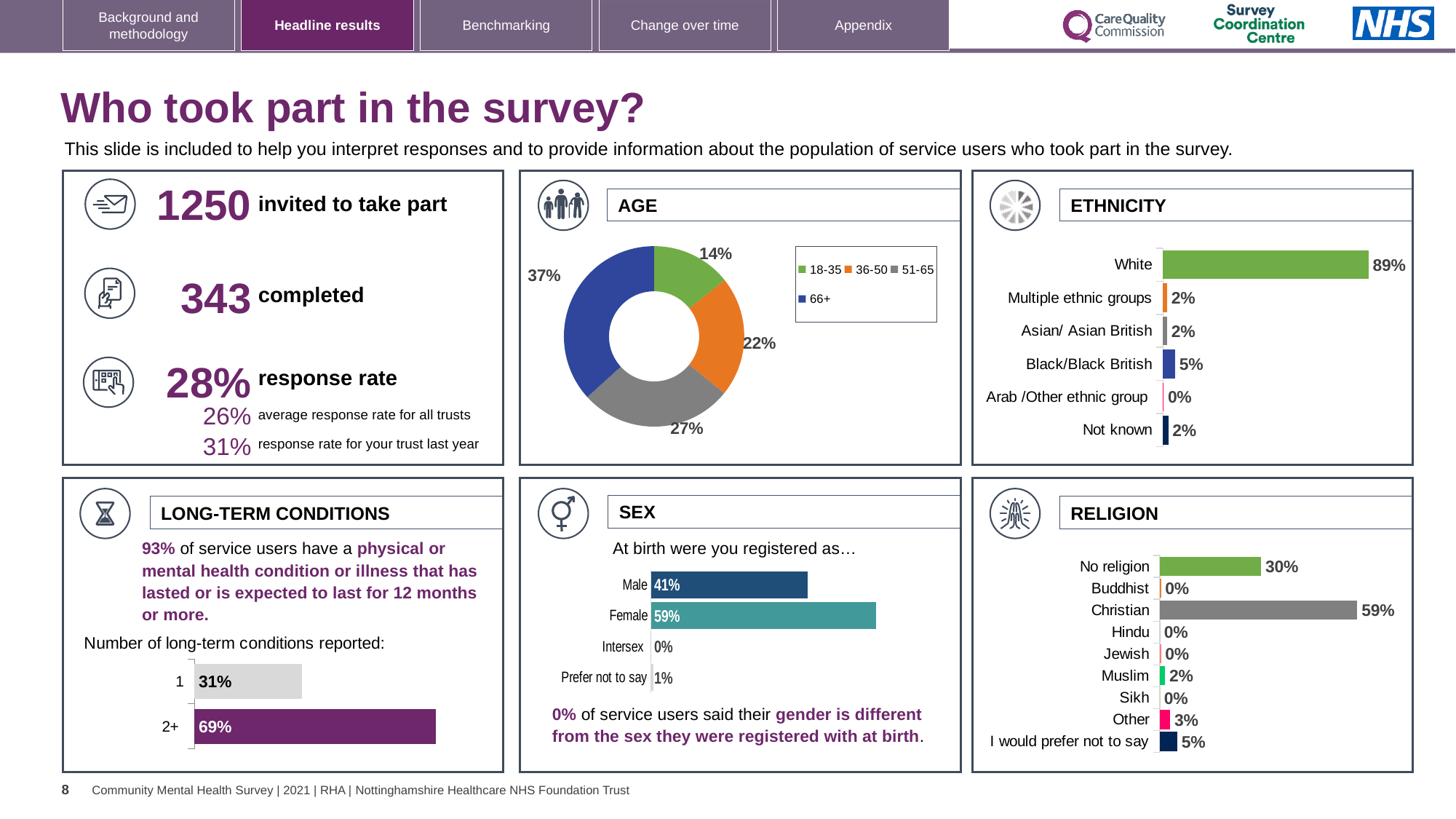
How many categories are shown in the RELIGION chart? 9 In the ETHNICITY chart, what is the difference between White and Black/Black British? 84% In the SEX chart, which is larger, Male or Female? Female What kind of chart is the AGE chart? Donut chart In the RELIGION chart, what is the value for No religion? 30% In the AGE chart, what percentage of respondents were aged 66+? 37% In the LONG-TERM CONDITIONS chart, what percentage reported 2+ conditions? 69% In the ETHNICITY chart, which category has the highest value? White In the AGE chart, which age group has the smallest share? 18-35 How many age groups does the legend of the AGE chart list? 4 In the SEX chart, what is the value for Prefer not to say? 1% In the ETHNICITY chart, what is the value for Black/Black British? 5%